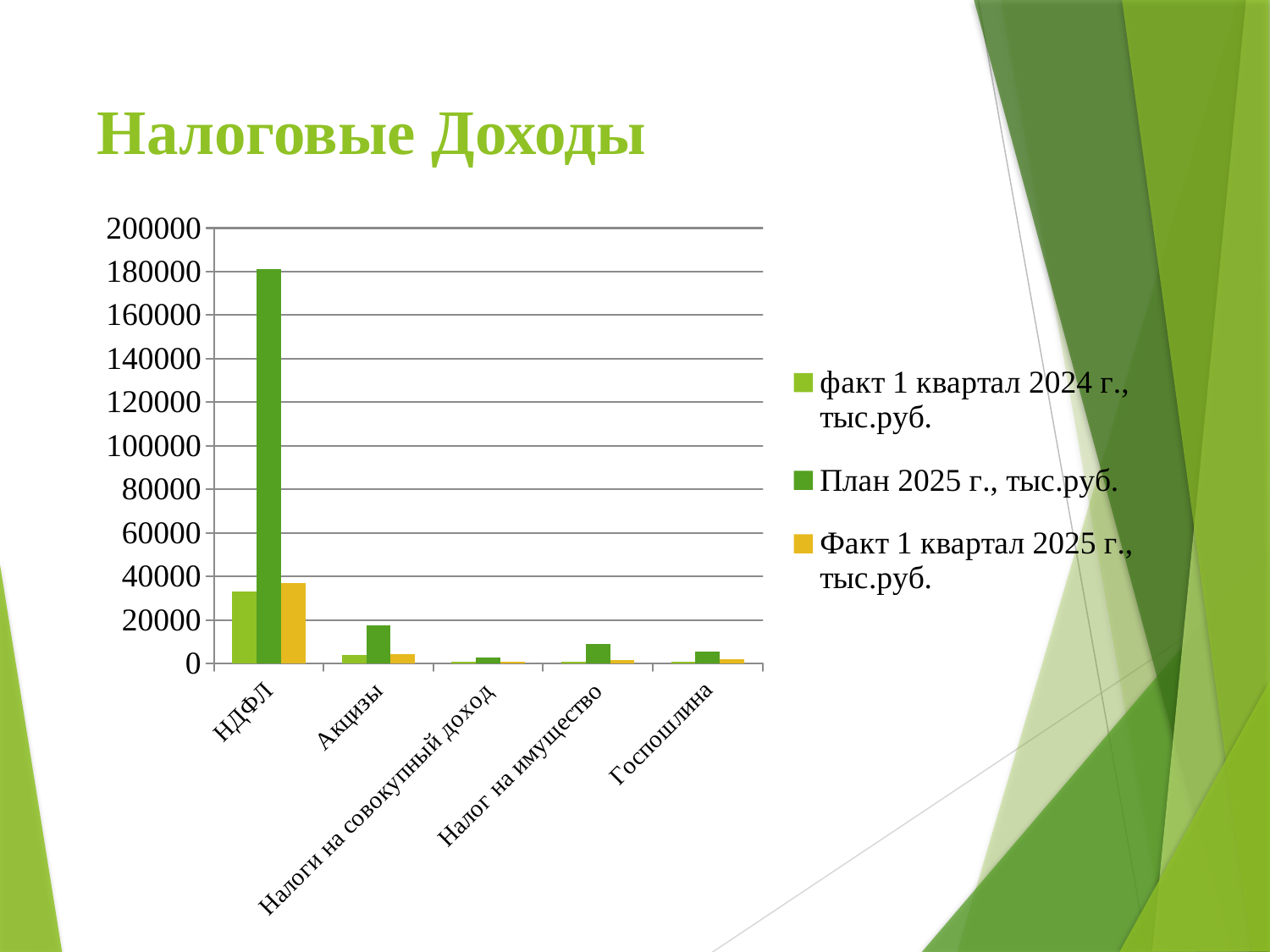
Which colour represents the series 'Факт 1 квартал 2025 г., тыс.руб.' in the legend? yellow Which category has the highest value for the series 'Факт 1 квартал 2025 г., тыс.руб.'? НДФЛ For Акцизы, which is larger: the value for 'План 2025 г., тыс.руб.' or the value for 'факт 1 квартал 2024 г., тыс.руб.'? План 2025 г., тыс.руб. Which category has the highest value for the series 'План 2025 г., тыс.руб.'? НДФЛ For НДФЛ, which is larger: the value for 'План 2025 г., тыс.руб.' or the value for 'Факт 1 квартал 2025 г., тыс.руб.'? План 2025 г., тыс.руб. What kind of chart is shown on the slide? bar chart How many series does the legend list? 3 Is the value for НДФЛ in the series 'План 2025 г., тыс.руб.' greater or less than 160000? greater How many categories are shown on the x axis of the chart? 5 Is the value for НДФЛ in the series 'факт 1 квартал 2024 г., тыс.руб.' greater or less than 40000? less Is the value for Акцизы in the series 'План 2025 г., тыс.руб.' greater or less than 20000? less What is the title of the chart? Налоговые Доходы